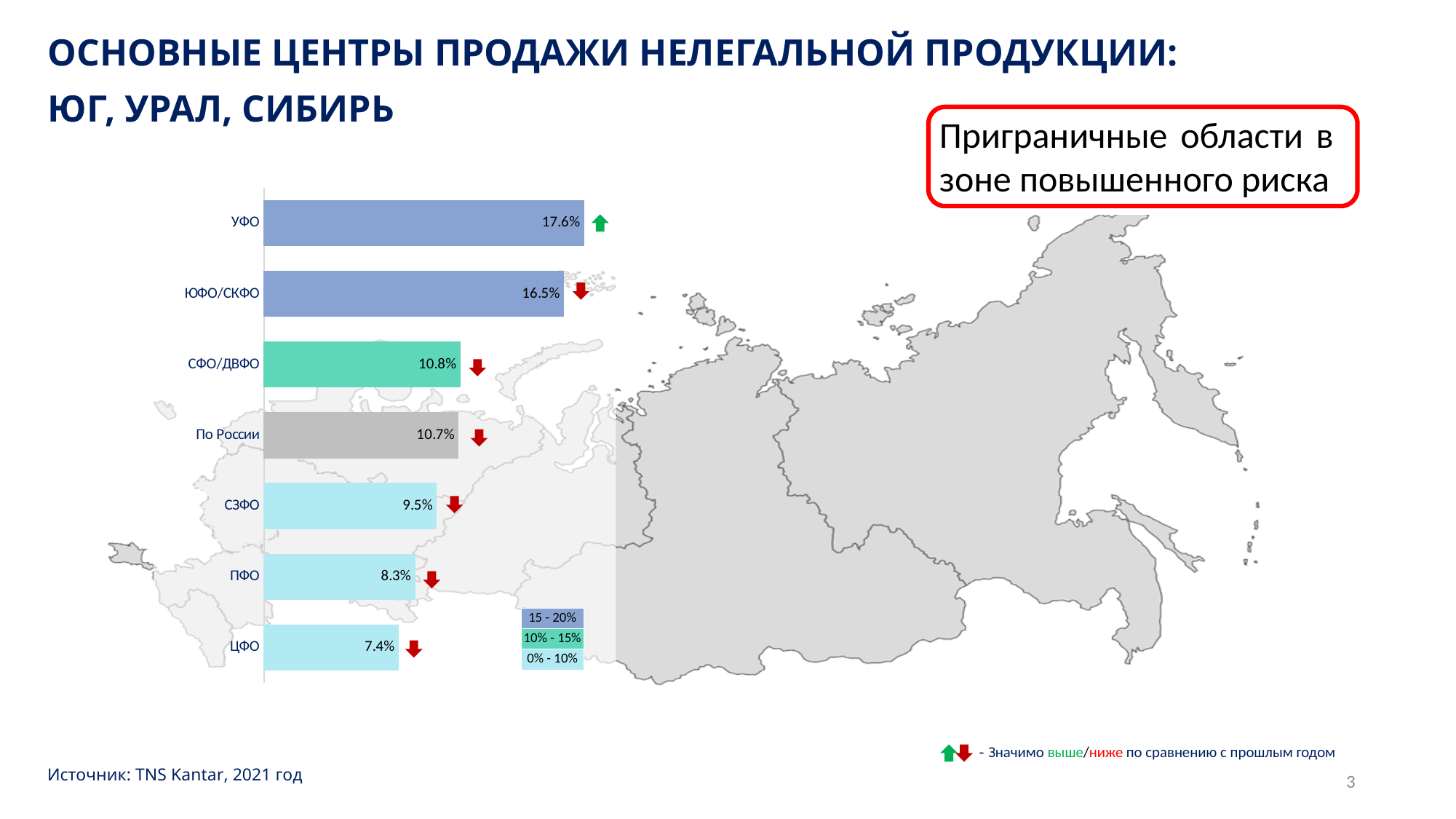
What is the value for ЮФО/СКФО? 16.5% What is the value for ЦФО? 7.4% How many categories are shown in the bar chart? 7 What is the value for УФО? 17.6% What is the value for По России? 10.7% What is the value for СФО/ДВФО? 10.8% What is the difference between the values for УФО and ЮФО/СКФО? 1.1% Which is larger, the value for СЗФО or the value for ПФО? СЗФО Which category has the highest value? УФО What kind of chart is shown on the slide? bar chart Which category has the lowest value? ЦФО Which category's bar is shown with a green upward arrow? УФО